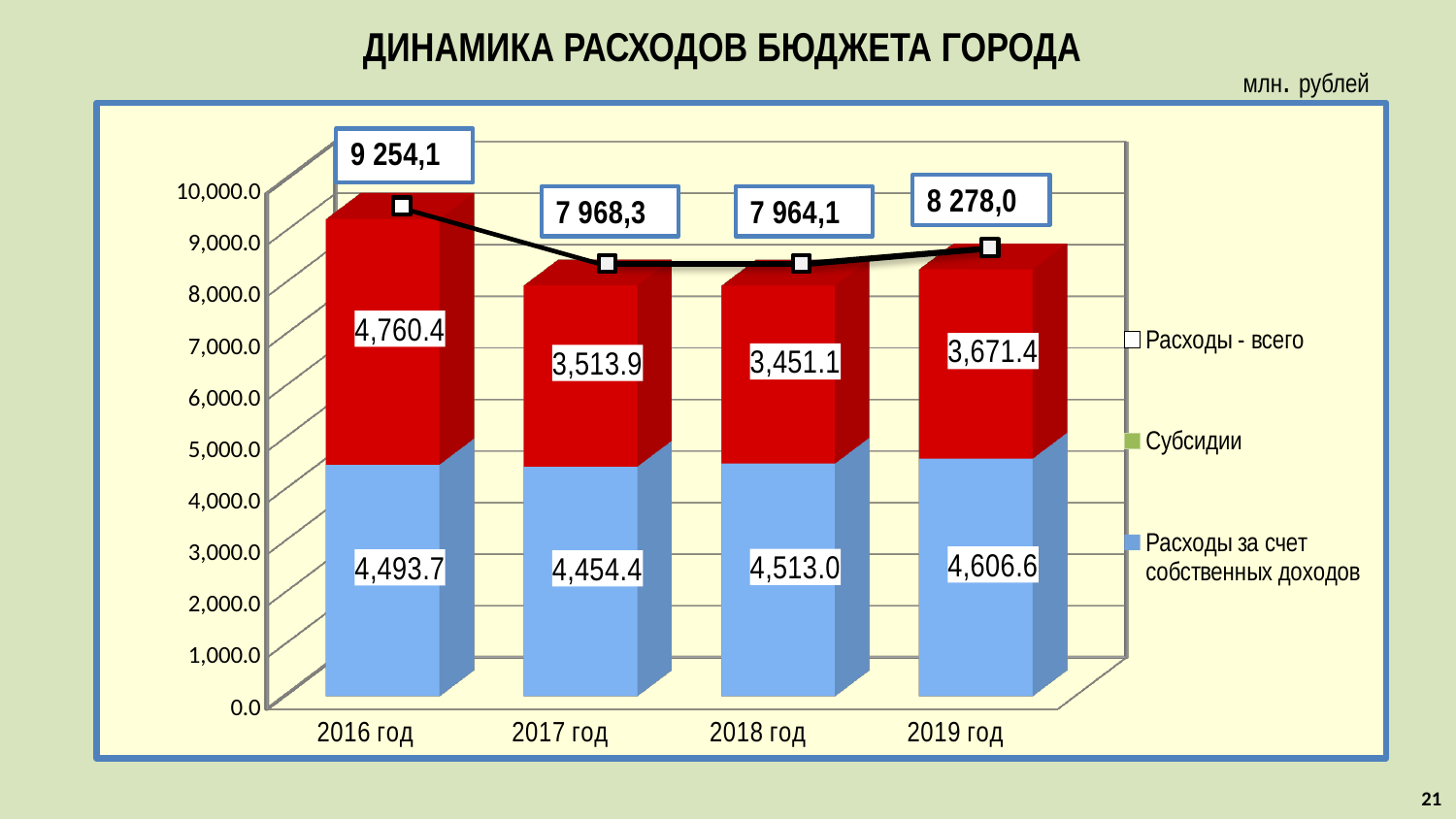
What is the difference between Расходы за счет собственных доходов in 2019 год and in 2018 год? 93.6 Which year has the lowest value of Расходы за счет собственных доходов? 2017 год What is the title of the chart? ДИНАМИКА РАСХОДОВ БЮДЖЕТА ГОРОДА What is the value of Расходы за счет собственных доходов for 2019 год? 4,606.6 What is the value of Расходы - всего for 2017 год? 7 968,3 How many years are shown on the x axis? 4 Which year has the highest value of Расходы - всего? 2016 год How many series does the legend list? 3 What kind of chart is shown on the slide? Stacked bar chart with a line